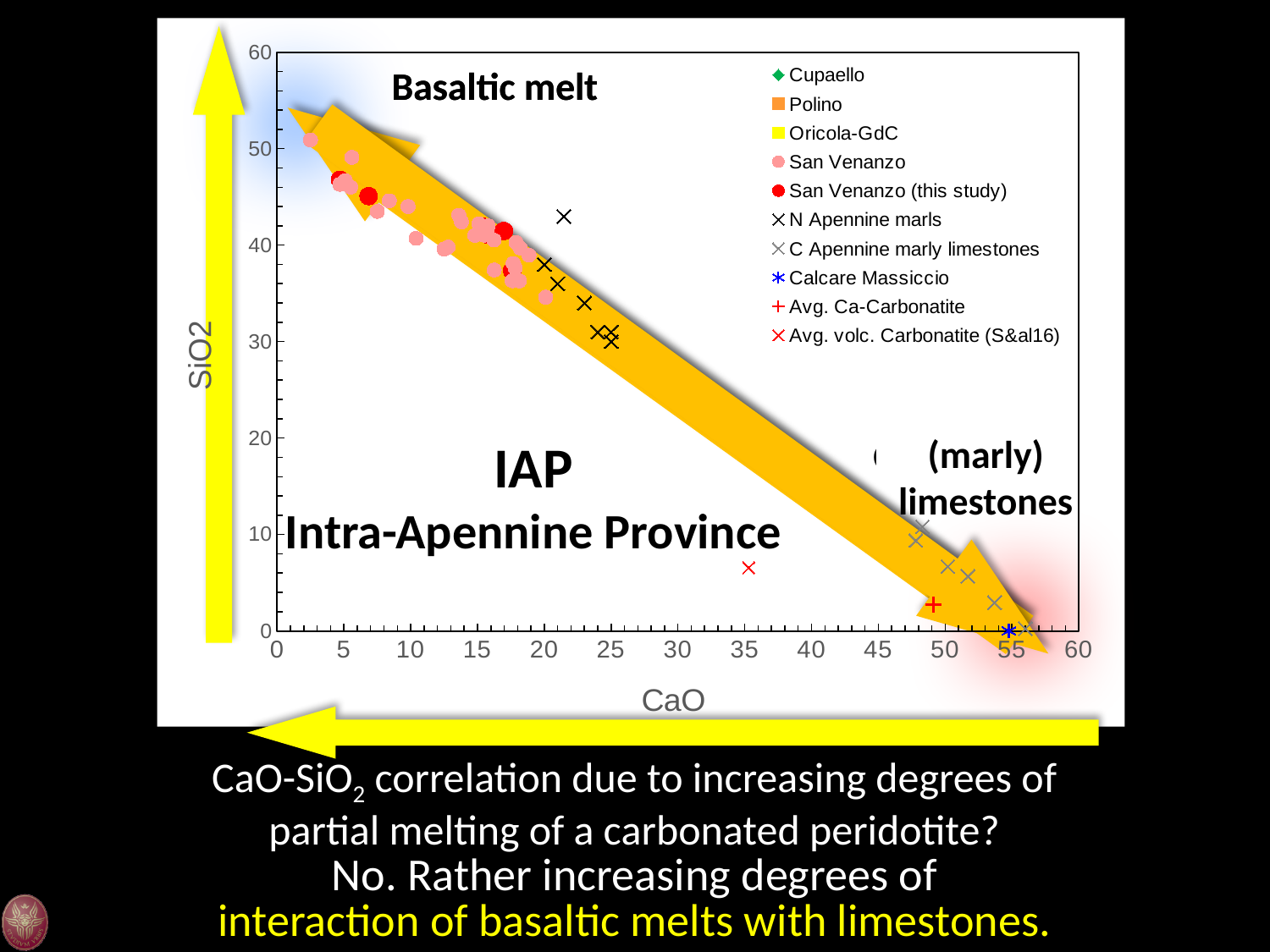
Are the SiO2 values for the San Venanzo (this study) points greater or less than 30? greater Is the SiO2 value for the Avg. volc. Carbonatite (S&al16) point greater or less than 10? less What kind of chart is shown on the slide? Scatter chart Is the SiO2 value for the Calcare Massiccio point greater or less than 5? less What is the label of the y axis? SiO2 How many series does the legend list? 10 As CaO increases along the x axis, does SiO2 rise or fall? Fall Which has the higher SiO2 value, the Avg. Ca-Carbonatite point or the Avg. volc. Carbonatite (S&al16) point? Avg. volc. Carbonatite (S&al16) What is the label of the x axis? CaO